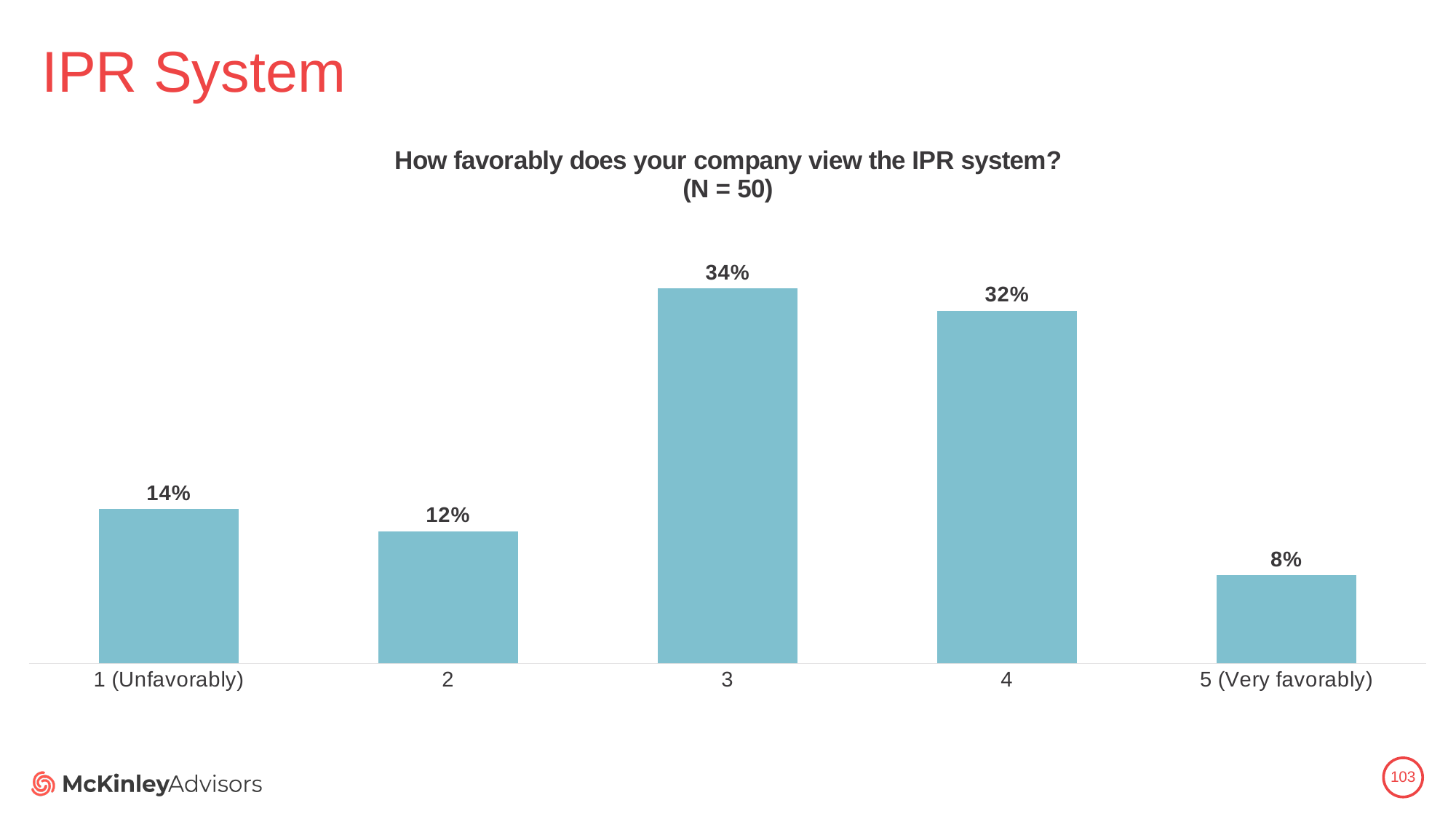
Which has a larger percentage: rating 2 or rating 5 (Very favorably)? 2 How many rating categories are shown on the chart? 5 Which rating category has the lowest percentage? 5 (Very favorably) What percentage of companies rated the IPR system 4? 32% What type of chart is shown on the slide? Bar chart What is the difference in percentage points between rating 3 and rating 4? 2 percentage points Which rating category has the highest percentage? 3 What percentage of companies rated the IPR system 1 (Unfavorably)? 14% What percentage of companies rated the IPR system 3? 34% What is the difference in percentage points between rating 1 (Unfavorably) and rating 2? 2 percentage points What percentage of companies rated the IPR system 5 (Very favorably)? 8% What is the sample size (N) stated in the chart title? 50